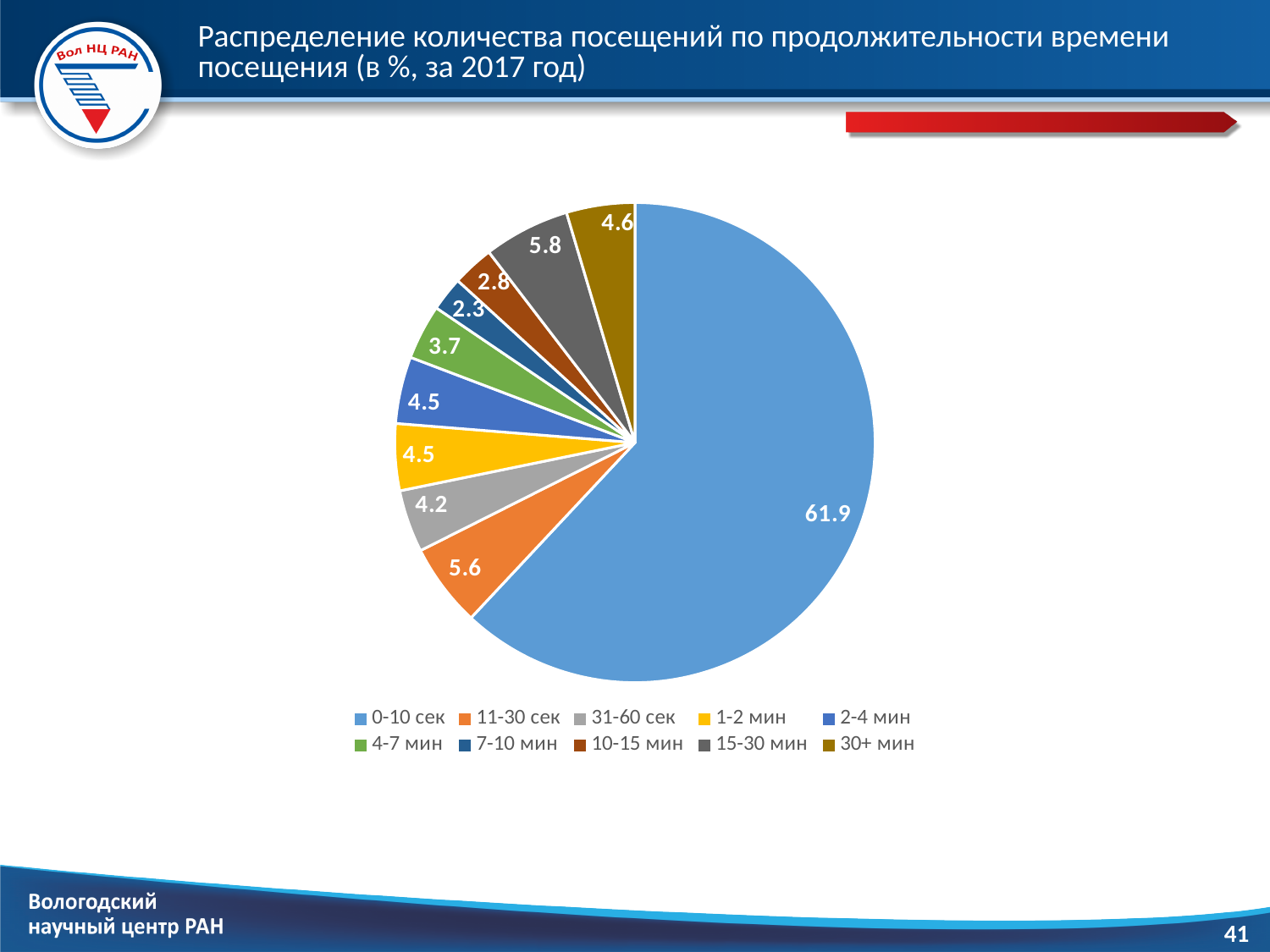
What is the value for the 15-30 мин slice? 5.8 Which category has the largest share of the pie? 0-10 сек How many slices does the pie chart have? 10 What is the value for the 7-10 мин slice? 2.3 What is the difference between the values for 11-30 сек and 31-60 сек? 1.4 What is the value for the 30+ мин slice? 4.6 What type of chart is shown on the slide? pie chart Which category has the smallest share of the pie? 7-10 мин What is the value for the 0-10 сек slice? 61.9 Which is larger, the value for 15-30 мин or the value for 4-7 мин? 15-30 мин What is the difference between the values for 0-10 сек and 15-30 мин? 56.1 Which year does the chart title say the data is for? 2017